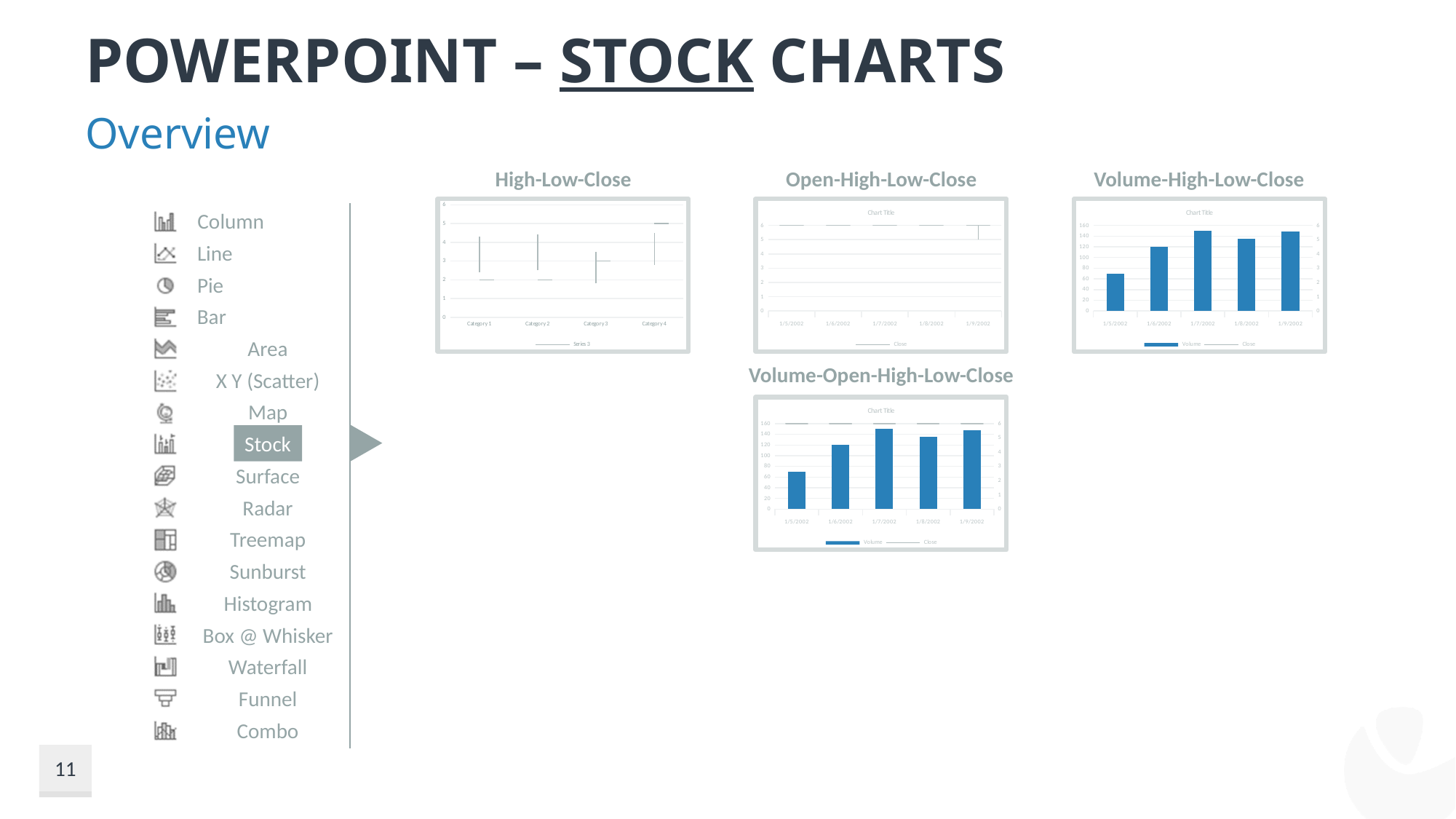
How many categories are shown on the x axis of the High-Low-Close chart? 4 In the Volume-High-Low-Close chart, which is larger, the volume bar for 1/5/2002 or for 1/6/2002? 1/6/2002 In the Volume-Open-High-Low-Close chart, is the volume bar for 1/6/2002 greater or less than 100? greater In the Volume-High-Low-Close chart, is the volume bar for 1/5/2002 greater or less than 80? less How many dates are shown on the x axis of the Open-High-Low-Close chart? 5 How many dates are shown on the x axis of the Volume-High-Low-Close chart? 5 In the Volume-Open-High-Low-Close chart, which is larger, the volume bar for 1/7/2002 or for 1/8/2002? 1/7/2002 In the Volume-High-Low-Close chart, is the volume bar for 1/7/2002 greater or less than 140? greater What series name appears in the legend of the High-Low-Close chart? Series 3 How many series does the legend of the Volume-High-Low-Close chart list? 2 How many series does the legend of the Volume-Open-High-Low-Close chart list? 2 In the Volume-High-Low-Close chart, which date has the lowest volume bar? 1/5/2002